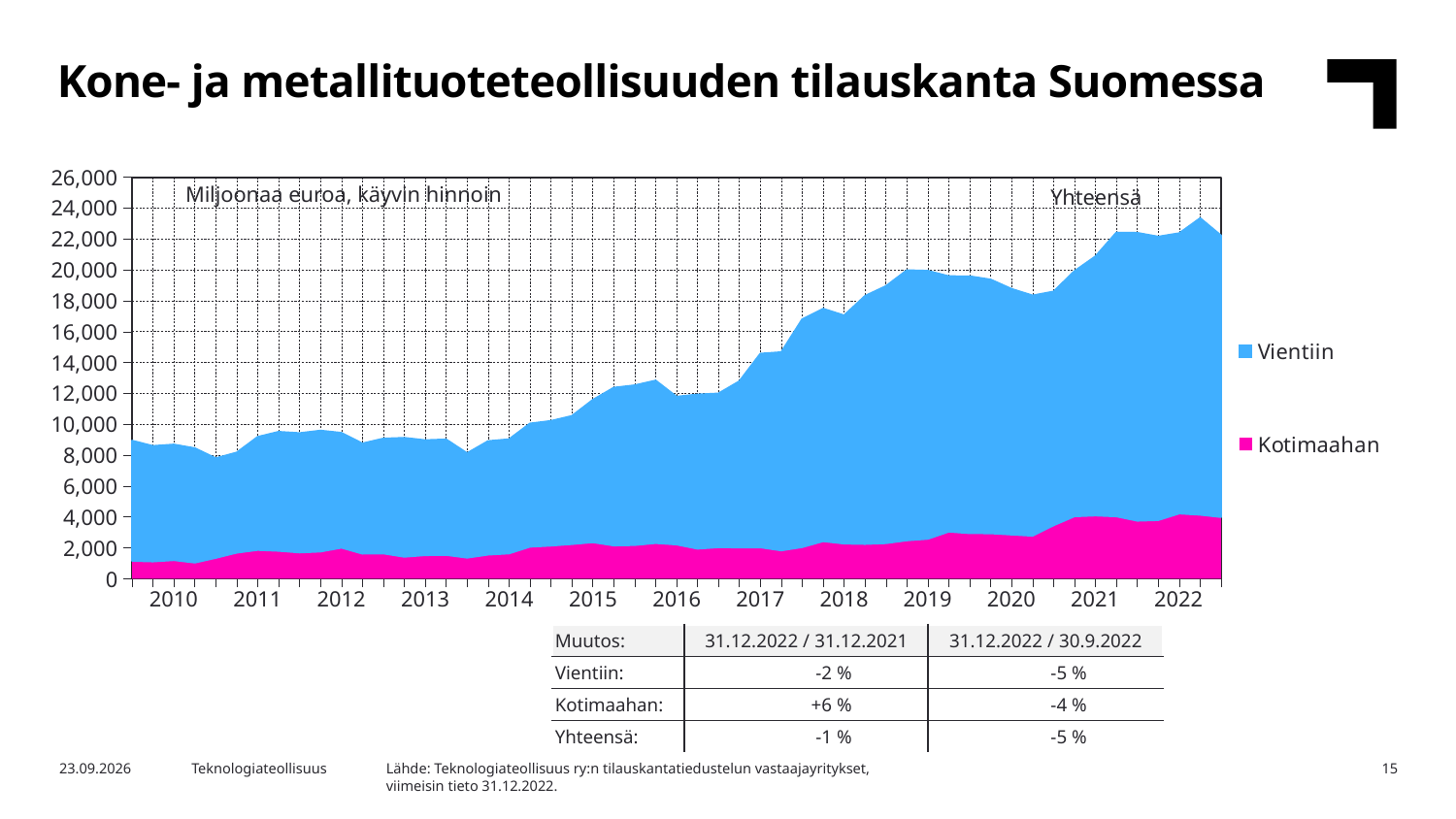
Is the total order book (Yhteensä) at the start of 2018 greater or less than 16,000? greater Is the total order book (Yhteensä) at the start of 2010 greater or less than 10,000? less Which is larger: the total order book in 2022 or in 2010? 2022 How many years are labeled on the x axis of the chart? 13 What kind of chart is shown on the slide? Stacked area chart Is the value for Kotimaahan in 2021 greater or less than 2,000? greater Does the total order book (Yhteensä) generally rise or fall from 2010 to 2022? rise What unit label is printed inside the chart area? Miljoonaa euroa, käyvin hinnoin Which two series are listed in the chart legend? Vientiin and Kotimaahan How many series does the chart legend list? 2